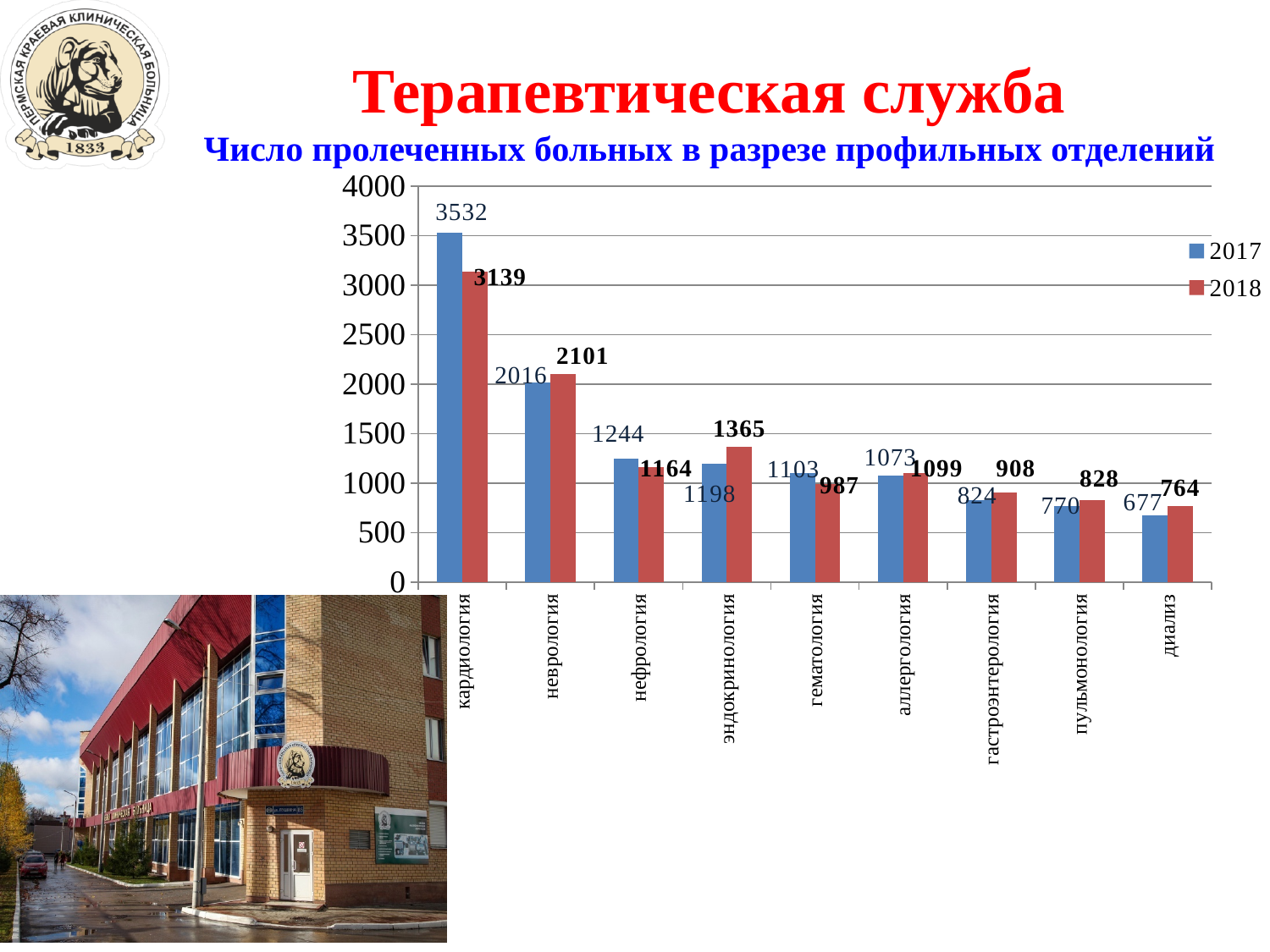
Which department has the highest 2017 value? кардиология How many departments are shown on the x axis? 9 For гематология, which is larger: the 2017 value or the 2018 value? 2017 What kind of chart is shown on the slide? bar chart Which department has the lowest 2018 value? диализ What is the difference between the 2017 and 2018 values for кардиология? 393 How many series does the legend list? 2 What is the 2018 value for диализ? 764 What is the difference between the 2018 and 2017 values for неврология? 85 What is the 2017 value for кардиология? 3532 What is the 2018 value for эндокринология? 1365 What is the 2017 value for гастроэнтерология? 824